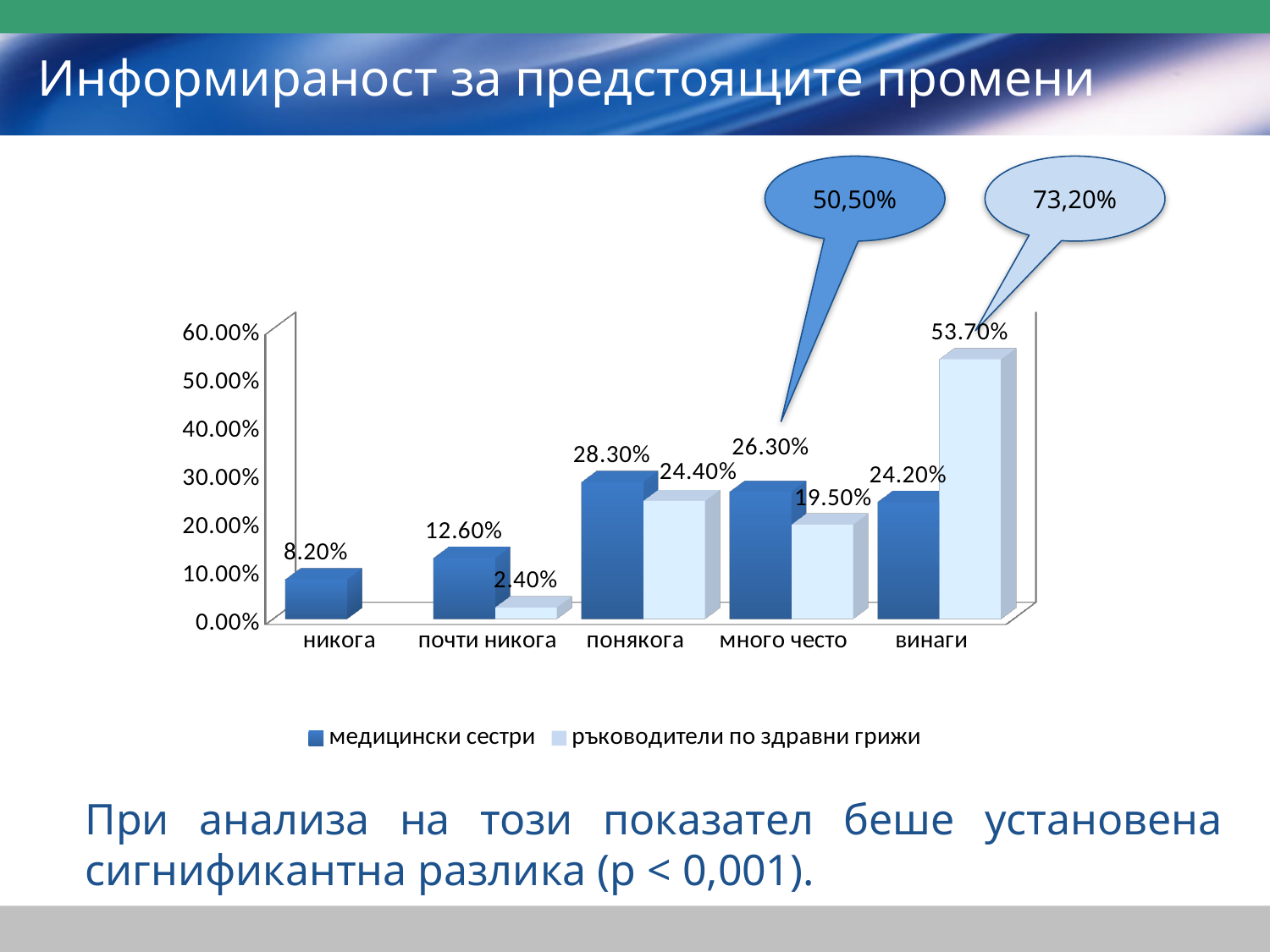
What is the difference between the ръководители по здравни грижи and медицински сестри values in the винаги category? 29.50% How many categories are shown on the x axis of the chart? 5 In the много често category, which series has the larger value: медицински сестри or ръководители по здравни грижи? медицински сестри Which category has the lowest value for медицински сестри? никога Which category has the highest value for ръководители по здравни грижи? винаги How many series does the chart legend list? 2 What value is shown for ръководители по здравни грижи in the винаги category? 53.70% What value is shown in the darker blue callout bubble above the chart? 50,50% What value is shown for медицински сестри in the понякога category? 28.30% What type of chart is shown on the slide? bar chart What value is shown for ръководители по здравни грижи in the почти никога category? 2.40% What value is shown for медицински сестри in the никога category? 8.20%